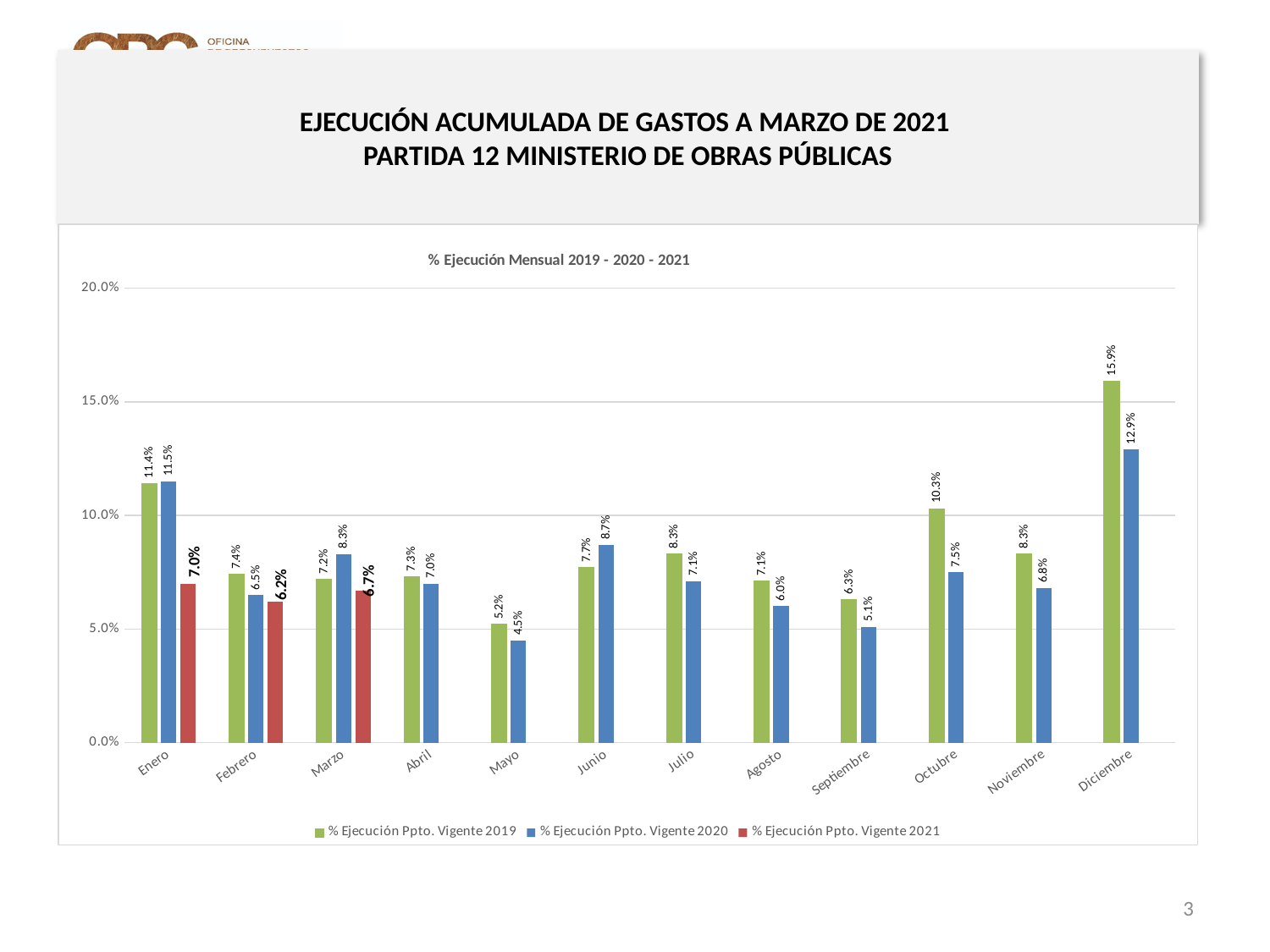
Which month has the highest value in the % Ejecución Ppto. Vigente 2020 series? Diciembre Is the value for Octubre in the % Ejecución Ppto. Vigente 2019 series greater or less than 10.0%? greater What is the value for Marzo in the % Ejecución Ppto. Vigente 2021 series? 6.7% What is the value for Diciembre in the % Ejecución Ppto. Vigente 2019 series? 15.9% What is the value for Mayo in the % Ejecución Ppto. Vigente 2020 series? 4.5% How many months have a bar for the % Ejecución Ppto. Vigente 2021 series? 3 Which month has the lowest value in the % Ejecución Ppto. Vigente 2019 series? Mayo What is the difference between the 2019 and 2020 values for Diciembre? 3.0% Which is larger for Marzo: the 2019 value or the 2020 value? 2020 How many series does the legend list? 3 What is the title of the chart? % Ejecución Mensual 2019 - 2020 - 2021 What type of chart is shown on the slide? bar chart